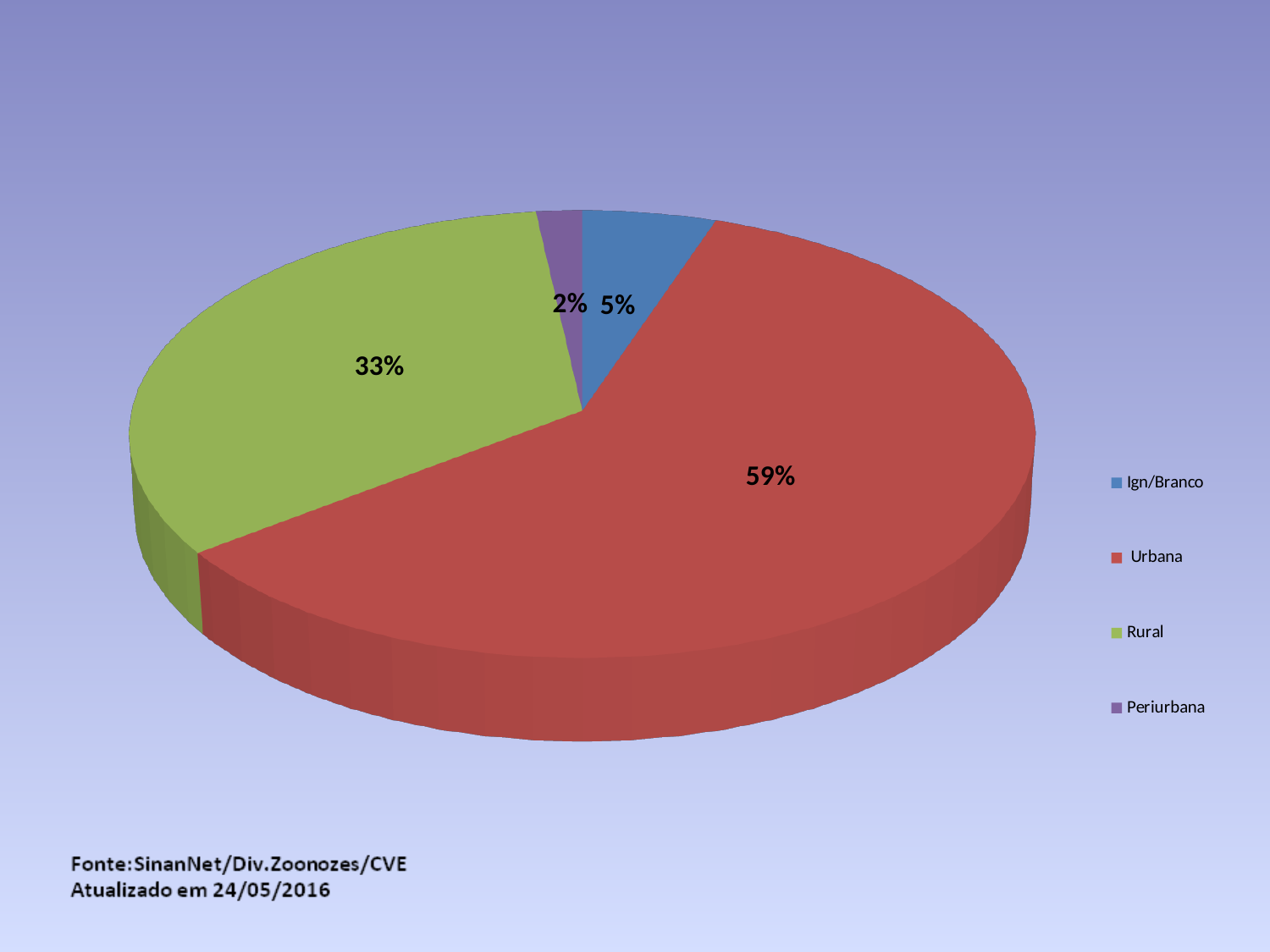
How many categories does the legend list? 4 Which category has the smallest slice of the pie? Periurbana Which is larger, the Rural slice or the Ign/Branco slice? Rural What share of the pie does Urbana represent? 59% What share of the pie does Periurbana represent? 2% What is the difference in percentage points between Urbana and Rural? 26 What source is cited below the chart? SinanNet/Div.Zoonozes/CVE Which category has the largest slice of the pie? Urbana What kind of chart is shown on the slide? Pie chart What share of the pie does Rural represent? 33% What colour is the Rural slice? Green